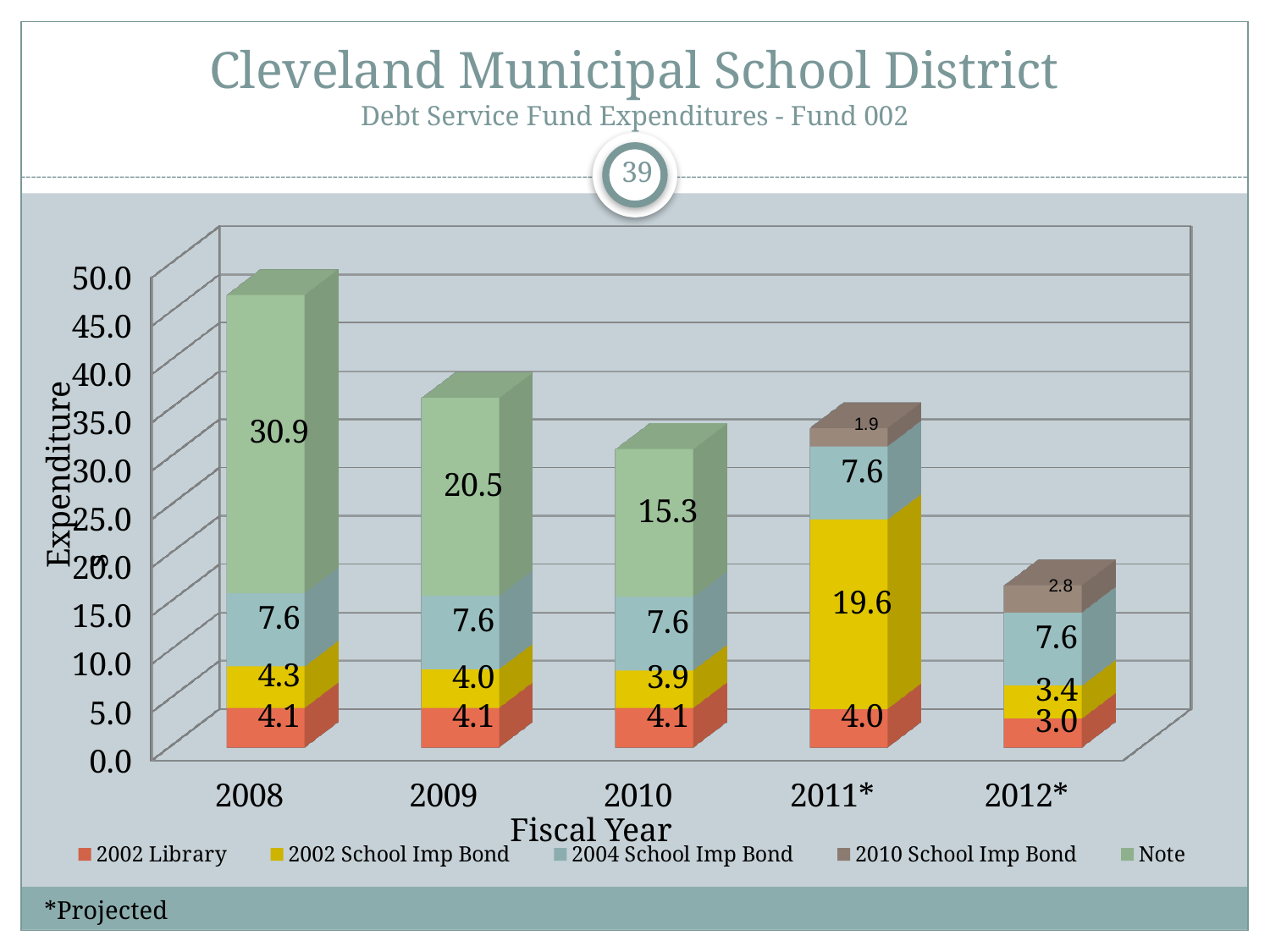
What is the value of the 2002 School Imp Bond segment for 2011*? 19.6 What is the total of the stacked bar for fiscal year 2008? 46.9 How many fiscal years are shown on the x axis? 5 How many series does the legend list? 5 What is the value of the Note segment for fiscal year 2008? 30.9 Which is larger, the 2002 School Imp Bond value for 2011* or the Note value for 2010? 2002 School Imp Bond for 2011* What is the difference between the Note values for 2008 and 2009? 10.4 Which fiscal year has the highest Note value? 2008 What kind of chart is shown on the slide? Stacked bar chart Does the Note value rise or fall from 2008 to 2010? Fall Which fiscal year has the lowest 2002 Library value? 2012* What is the value of the 2010 School Imp Bond segment for 2012*? 2.8